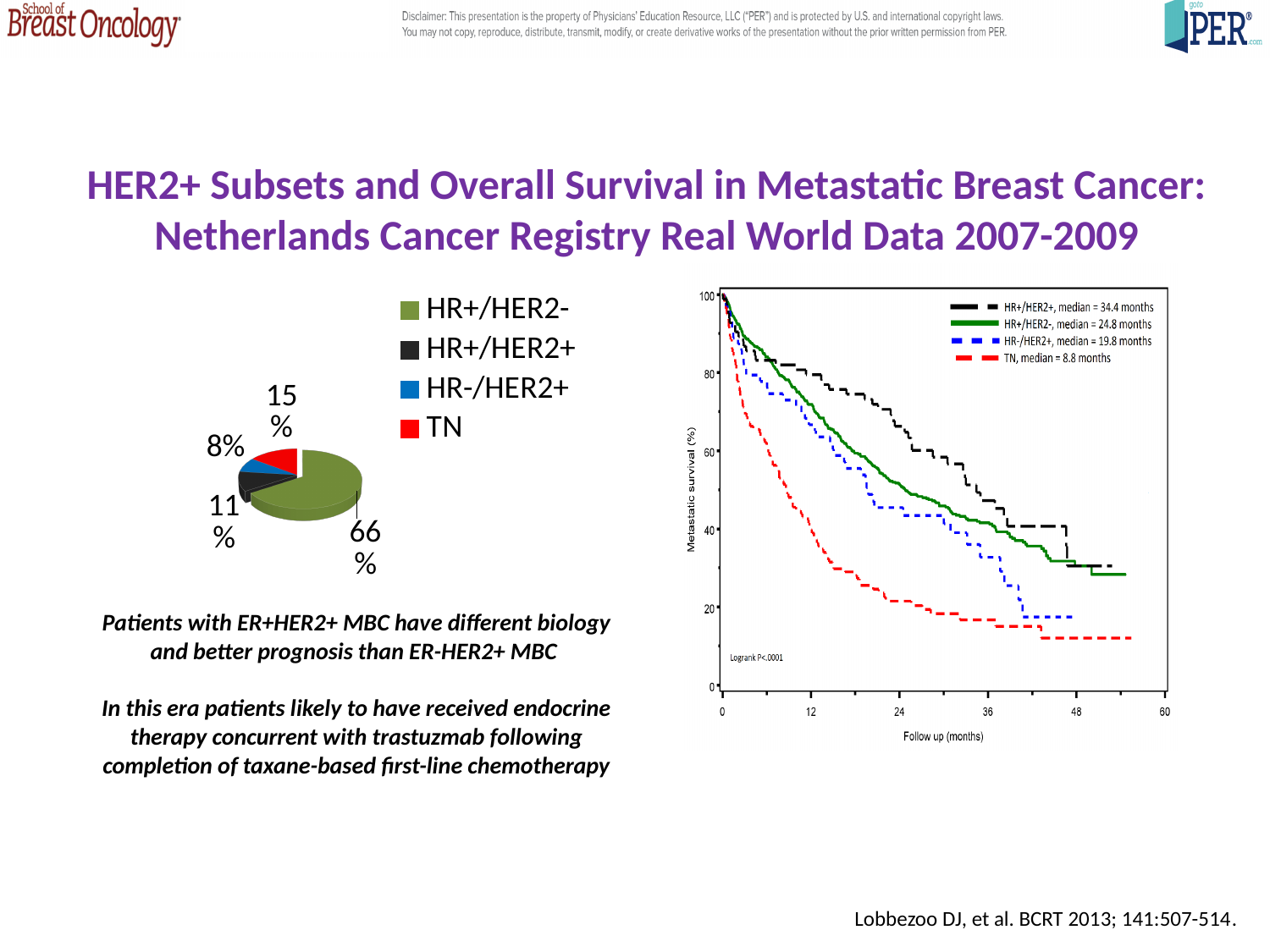
On the pie chart, what share of patients is TN? 15% What kind of chart is on the left side of the slide? Pie chart On the pie chart, what is the difference in percentage points between the HR+/HER2+ and HR-/HER2+ shares? 3 On the pie chart, what share of patients is HR-/HER2+? 8% On the pie chart, which subset has the largest share? HR+/HER2- On the survival plot, what is the median survival for TN patients? 8.8 months On the survival plot, what is the median survival for HR+/HER2+ patients? 34.4 months On the pie chart, which subset has the smallest share? HR-/HER2+ On the survival plot, which group has the lowest median survival? TN On the pie chart, what share of patients is HR+/HER2-? 66% On the survival plot, what is the label of the x axis? Follow up (months) How many slices does the pie chart have? 4